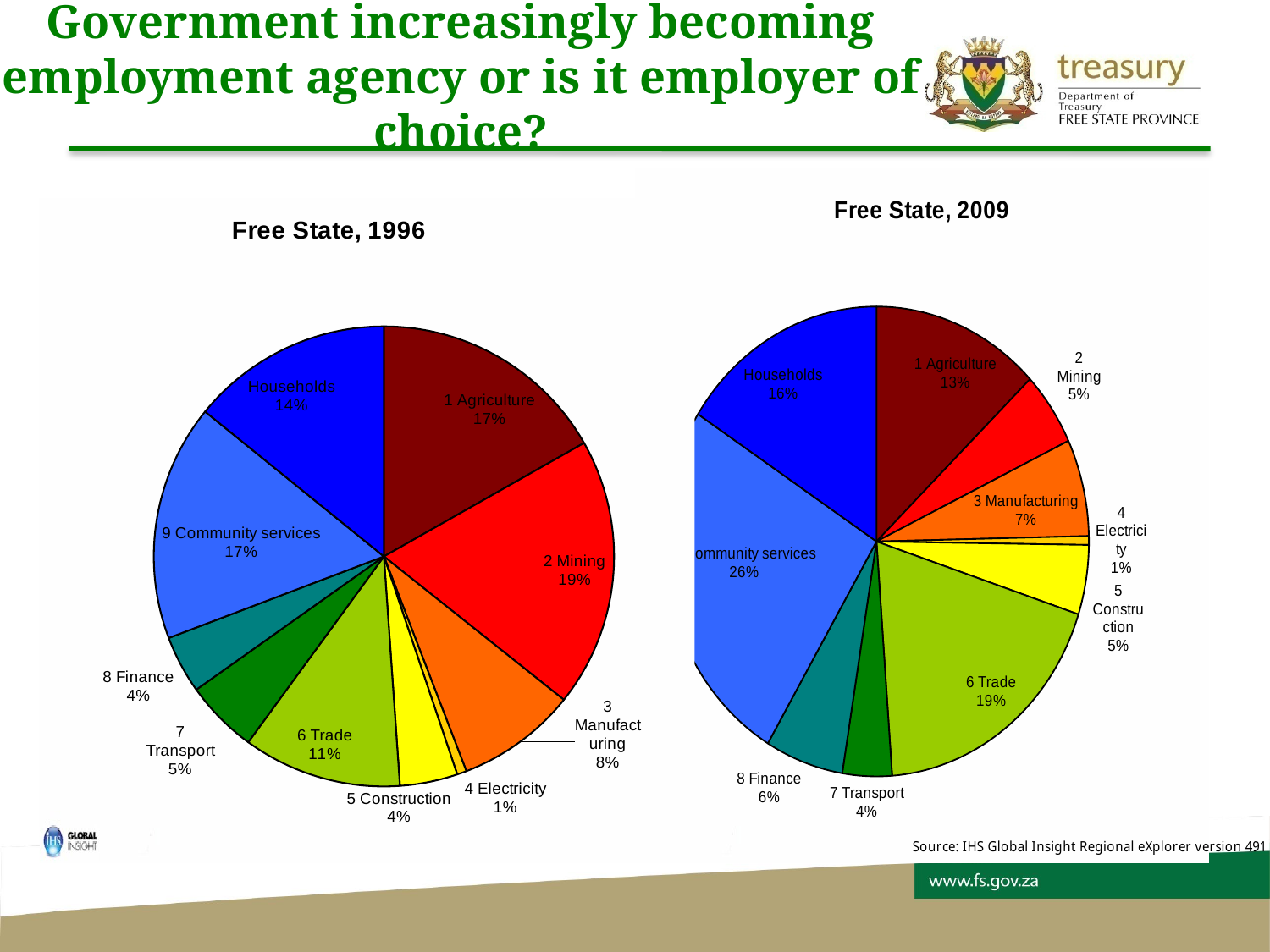
In the Free State, 2009 chart, what share does 9 Community services have? 26% In the Free State, 1996 chart, which sector has the largest share? 2 Mining How many slices does the Free State, 1996 pie chart have? 10 In the Free State, 2009 chart, what is the difference between the shares of Households and 1 Agriculture? 3% In the Free State, 2009 chart, which is larger, 6 Trade or 1 Agriculture? 6 Trade In the Free State, 1996 chart, what share does 3 Manufacturing have? 8% In the Free State, 1996 chart, what is the difference between the shares of 2 Mining and 6 Trade? 8% In the Free State, 2009 chart, which sector has the largest share? 9 Community services In the Free State, 1996 chart, what share does 2 Mining have? 19% In the Free State, 2009 chart, which sector has the smallest share? 4 Electricity In the Free State, 1996 chart, which is larger, 8 Finance or 7 Transport? 7 Transport What kind of charts are shown on the slide? Pie charts